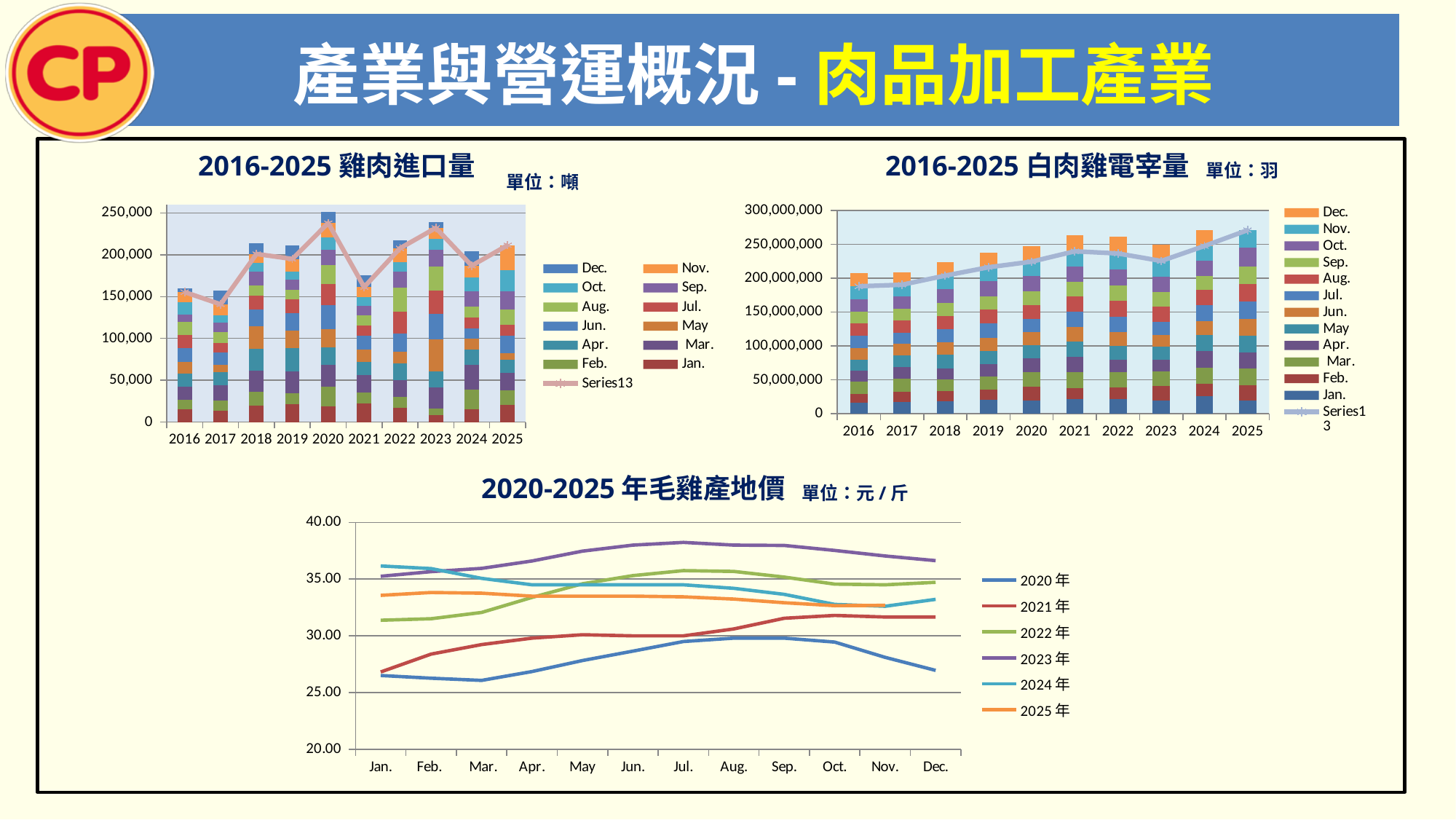
In the '2016-2025 雞肉進口量' chart, is the total for 2021 greater or less than 200,000? less How many months are shown on the x axis of the '2020-2025 年毛雞產地價' chart? 12 In the '2016-2025 白肉雞電宰量' chart, is the total for 2025 greater or less than 250,000,000? greater In the '2020-2025 年毛雞產地價' chart, is the value for 2023 年 in Jul. greater or less than 35.00? greater What type of chart is the '2020-2025 年毛雞產地價' chart? line chart How many years are shown on the x axis of the '2016-2025 白肉雞電宰量' chart? 10 How many series does the legend of the '2020-2025 年毛雞產地價' chart list? 6 What unit is stated for the '2016-2025 白肉雞電宰量' chart? 羽 In the '2020-2025 年毛雞產地價' chart, which year's line is highest in Jul.? 2023 年 In the '2020-2025 年毛雞產地價' chart, does the 2021 年 line rise or fall from Jan. to Dec.? rise In the '2016-2025 雞肉進口量' chart, which year has the tallest stacked bar? 2020